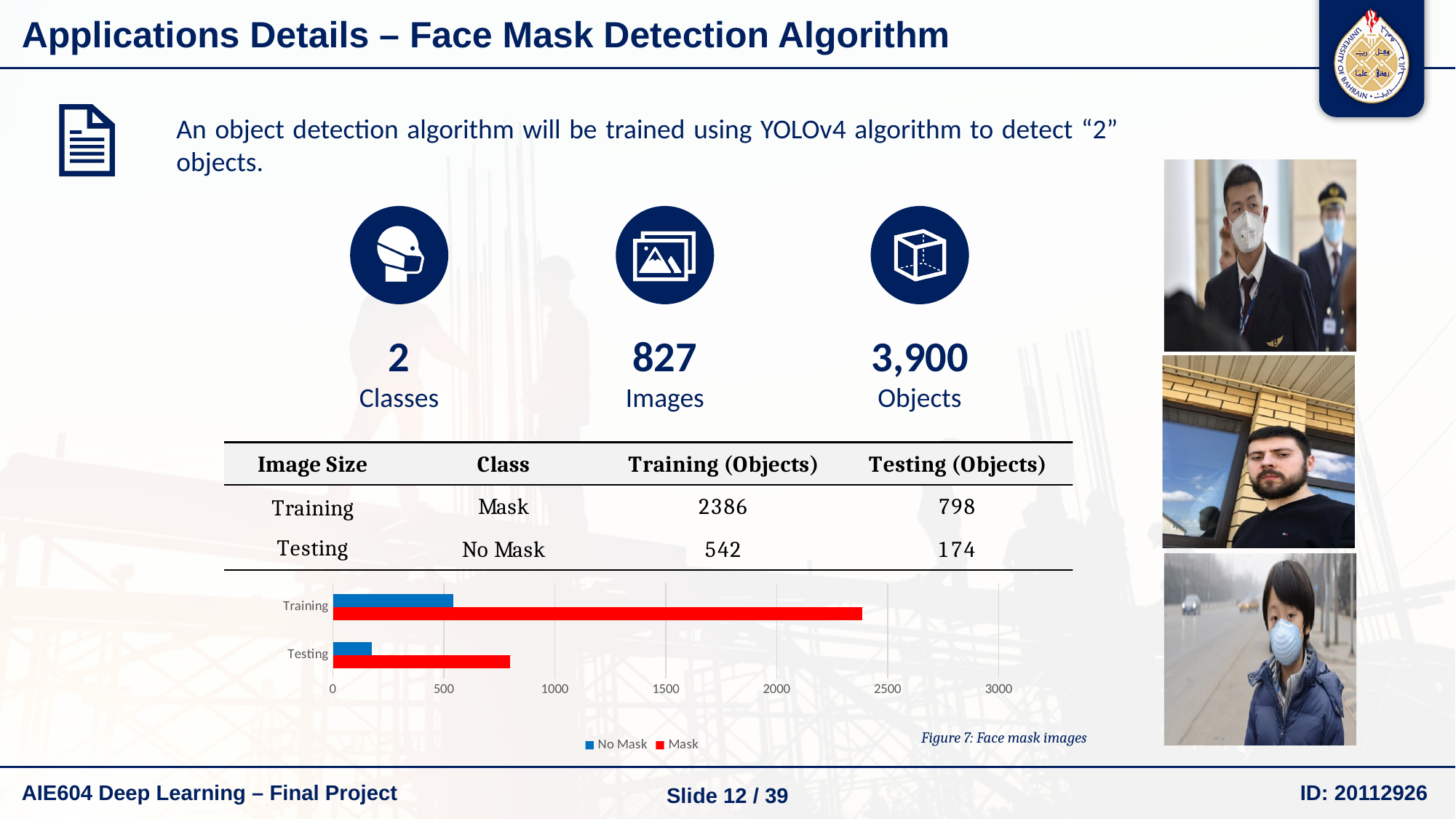
For Training, which series has the larger value, Mask or No Mask? Mask Which category has the shortest No Mask bar? Testing Is the No Mask value for Testing greater or less than 500? less What kind of chart is shown at the bottom of the slide? bar chart How many categories are shown on the chart's vertical axis? 2 Is the Mask value for Training greater or less than 2000? greater Which series is shown in blue in the chart? No Mask Which category has the longest Mask bar? Training Is the No Mask value for Training greater or less than 1000? less Which series is shown in red in the chart? Mask How many series does the chart legend list? 2